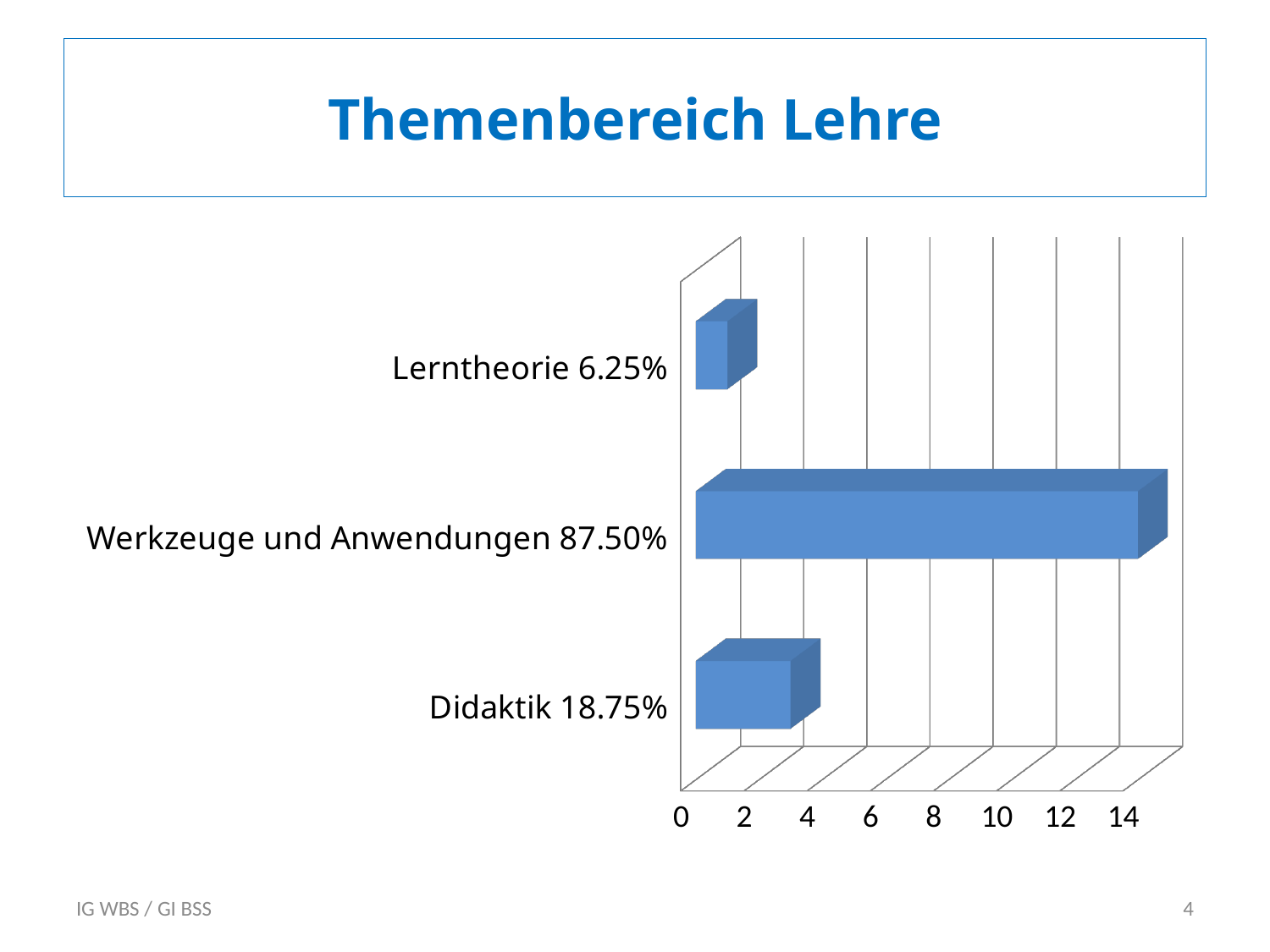
Which category has the longest bar? Werkzeuge und Anwendungen Is the value for Didaktik greater or less than 2? greater Which category has the shortest bar? Lerntheorie How many categories are plotted in the chart? 3 What is the title of the slide containing the chart? Themenbereich Lehre What percentage is printed in the category label for Didaktik? 18.75% What percentage is printed in the category label for Werkzeuge und Anwendungen? 87.50% What is the highest tick value shown on the horizontal axis? 14 Is the value for Werkzeuge und Anwendungen greater or less than 12? greater Which bar is longer, Didaktik or Lerntheorie? Didaktik Is the value for Lerntheorie greater or less than 2? less What kind of chart is shown on the slide? bar chart